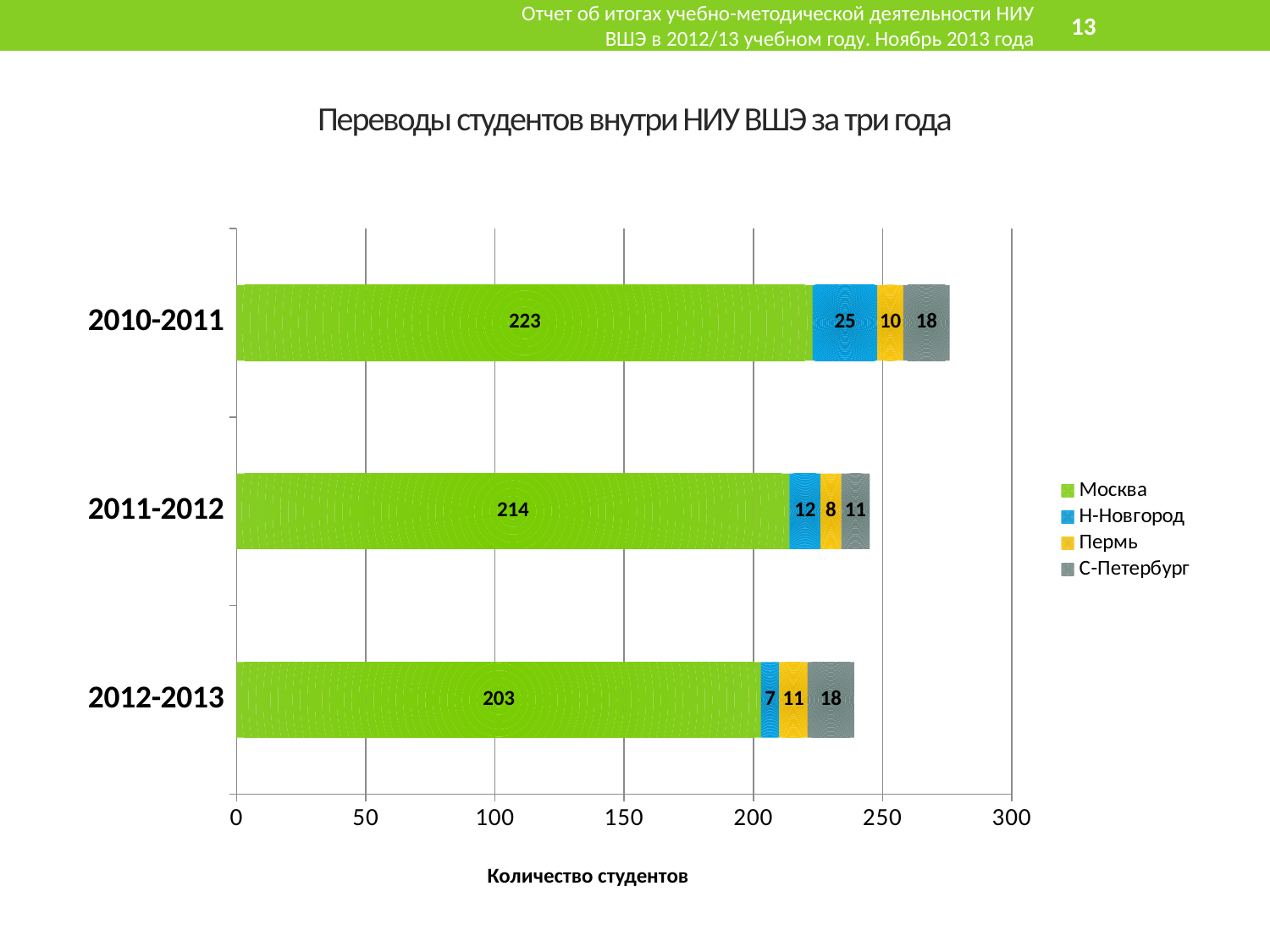
What is the difference between the Москва values for 2010-2011 and 2012-2013? 20 What is the title of the chart? Переводы студентов внутри НИУ ВШЭ за три года How many academic years (categories) are shown on the chart? 3 Does the value for Москва rise or fall from 2010-2011 to 2012-2013? Fall In which academic year is the value for Н-Новгород the highest? 2010-2011 What is the value for Москва in 2010-2011? 223 What is the total of the stacked bar for 2011-2012? 245 How many series does the legend list? 4 What is the value for Пермь in 2012-2013? 11 In which academic year is the value for Москва the lowest? 2012-2013 What is the value for Н-Новгород in 2011-2012? 12 What type of chart is shown on the slide? Stacked bar chart